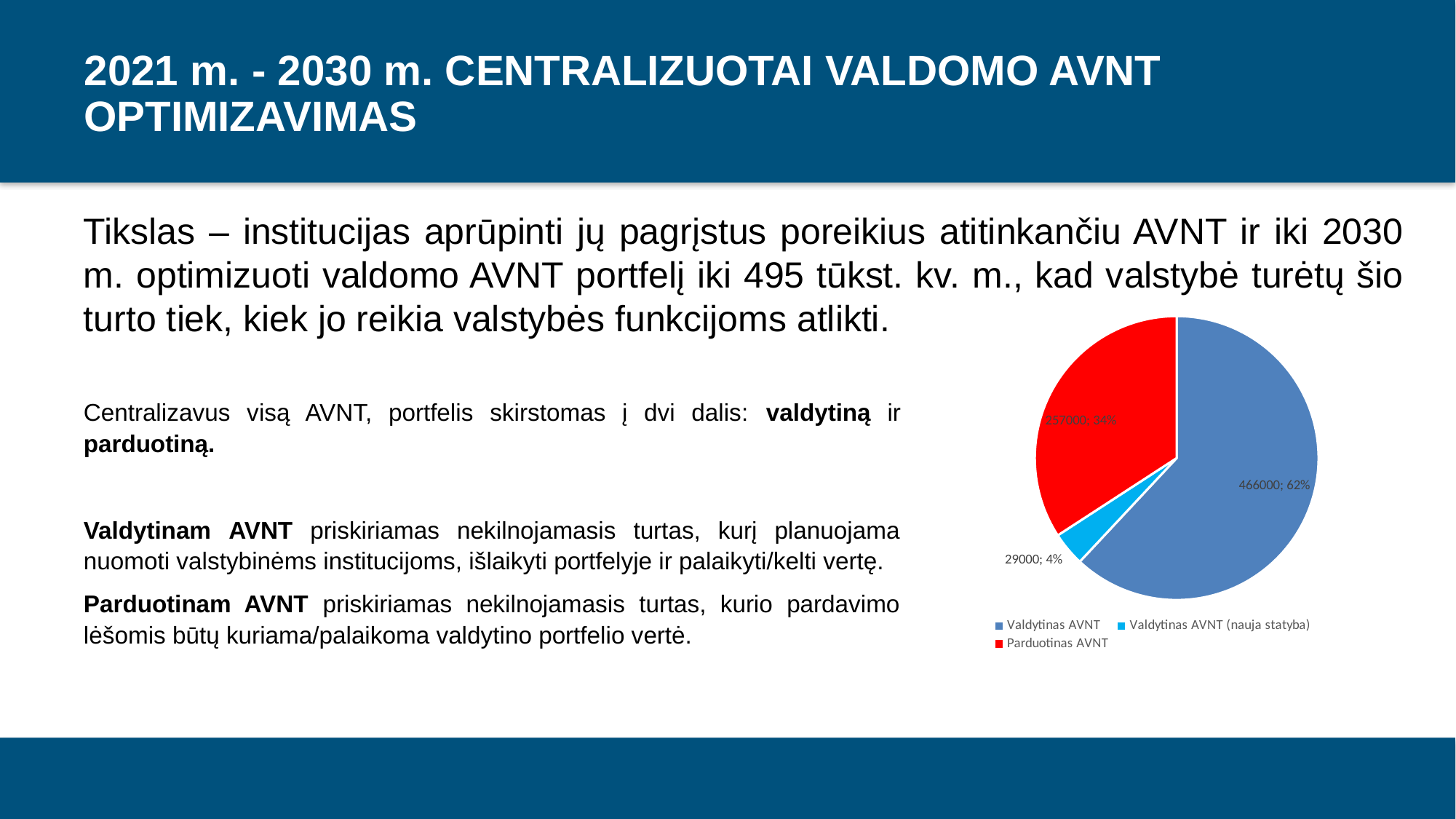
Which category has the largest slice in the pie chart? Valdytinas AVNT Which category has the smallest slice in the pie chart? Valdytinas AVNT (nauja statyba) What value is shown for Valdytinas AVNT in the pie chart? 466000 What is the difference between the values for Valdytinas AVNT and Parduotinas AVNT? 209000 What percentage share of the pie does Parduotinas AVNT have? 34% Which colour represents Parduotinas AVNT in the pie chart? red What kind of chart is shown on the slide? pie chart How many slices does the pie chart have? 3 What percentage share of the pie does Valdytinas AVNT (nauja statyba) have? 4% What value is shown for Valdytinas AVNT (nauja statyba) in the pie chart? 29000 What value is shown for Parduotinas AVNT in the pie chart? 257000 What percentage share of the pie does Valdytinas AVNT have? 62%